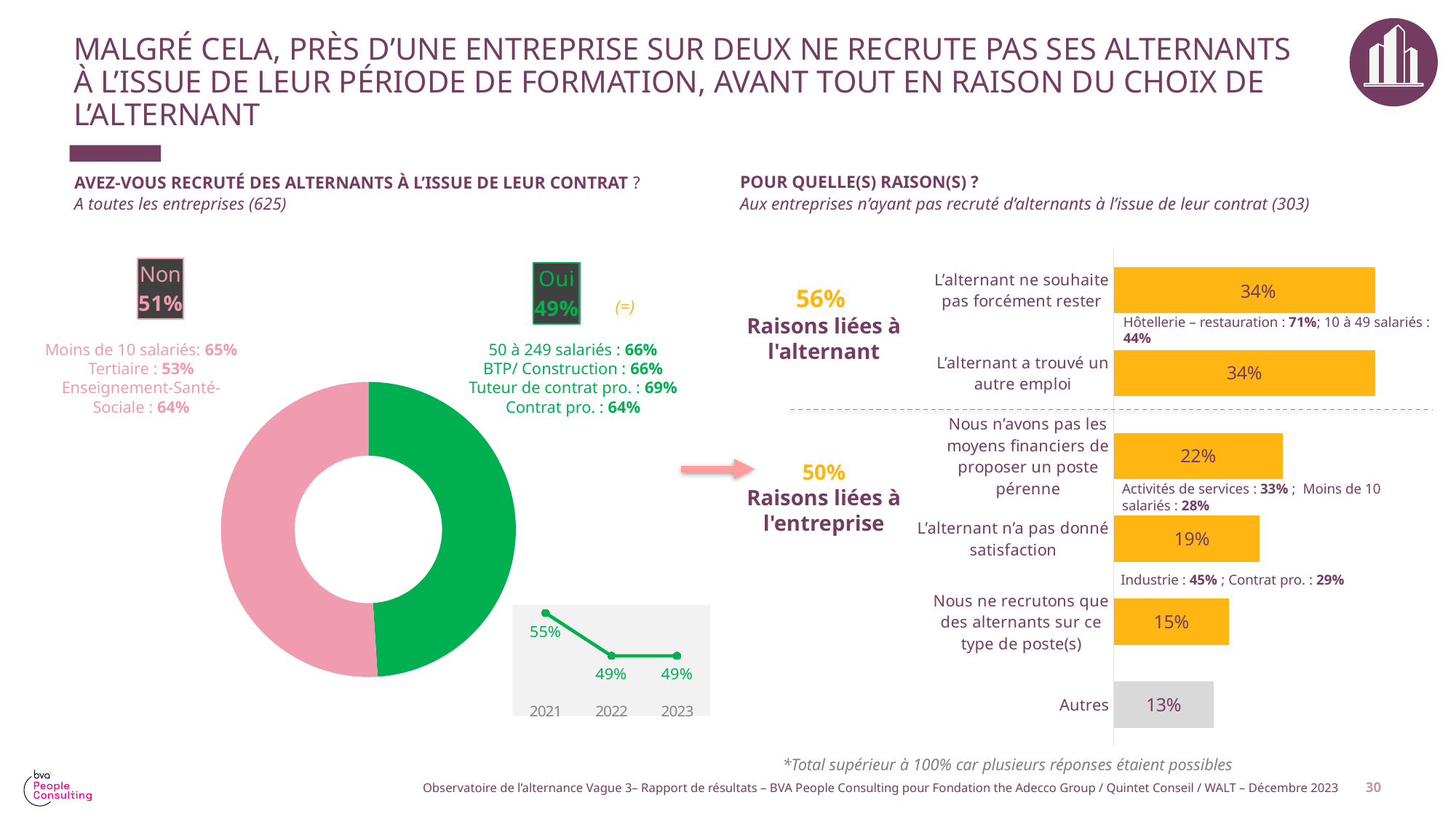
In the small line chart below the donut, what is the value for 2021? 55% In the donut chart on the left, how many slices are there? 2 In the bar chart on the right ("Pour quelle(s) raison(s) ?"), what is the value for "L'alternant a trouvé un autre emploi"? 34% In the donut chart on the left, what share of companies answered "Non"? 51% In the bar chart on the right ("Pour quelle(s) raison(s) ?"), which reason has the lowest value? Autres In the small line chart below the donut, do the values rise or fall from 2021 to 2023? fall In the donut chart on the left, which answer has the larger share, "Non" or "Oui"? Non In the bar chart on the right ("Pour quelle(s) raison(s) ?"), what is the difference between "Nous n'avons pas les moyens financiers de proposer un poste pérenne" and "L'alternant n'a pas donné satisfaction"? 3 percentage points In the donut chart on the left, what share of companies answered "Oui"? 49% In the small line chart below the donut, what is the difference between the 2021 and 2022 values? 6 percentage points In the small line chart below the donut, what is the value for 2023? 49% What kind of chart is used on the right of the slide to show the reasons for not recruiting? bar chart